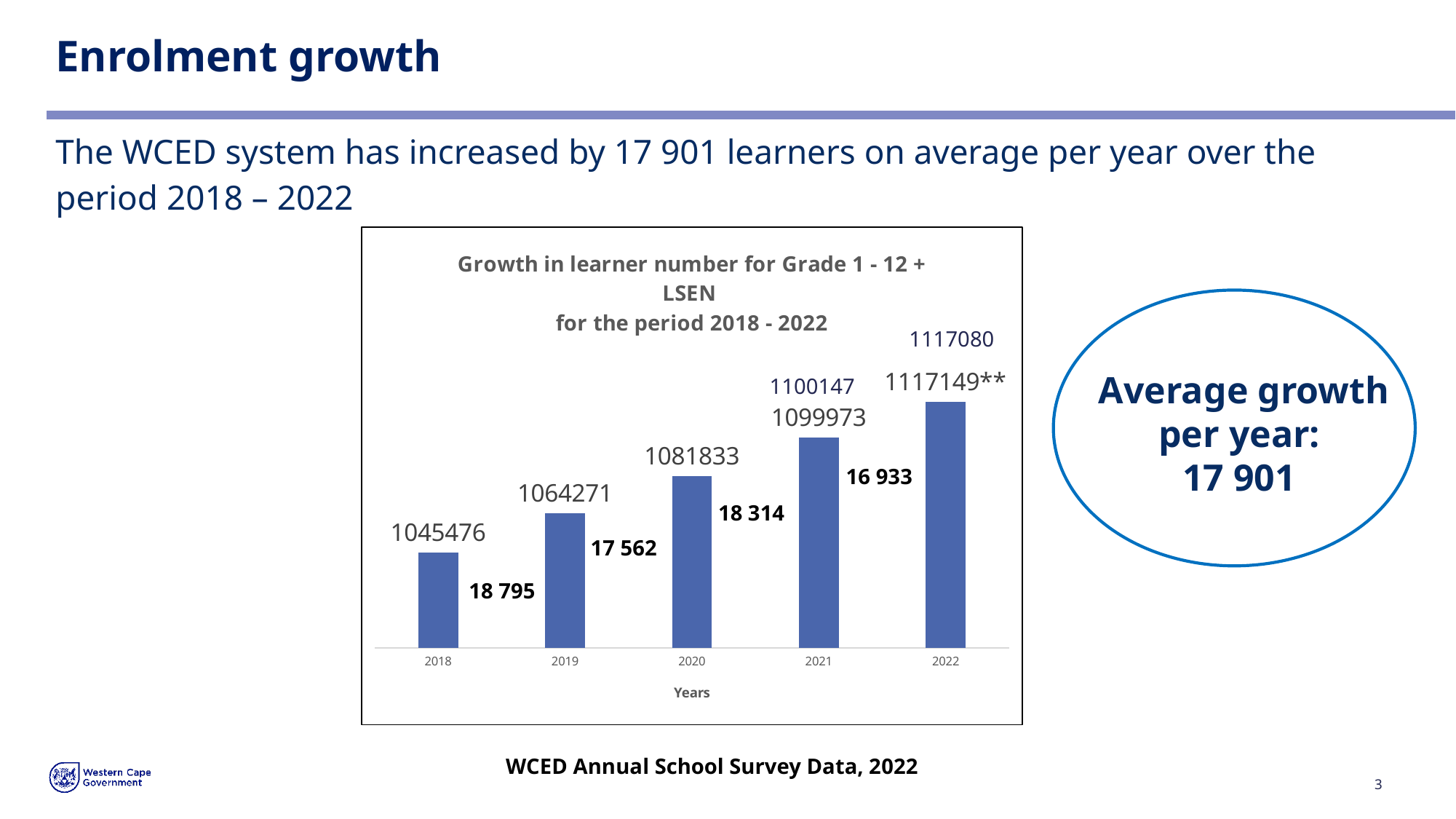
What is the learner number shown for 2020? 1081833 Which year has the larger learner number, 2019 or 2020? 2020 What is the title of the x axis of the chart? Years By how much did the learner number increase from 2018 to 2019? 18 795 What is the learner number shown for 2019? 1064271 Do the learner numbers rise or fall from 2018 to 2022? rise By how much did the learner number increase from 2019 to 2020? 17 562 How many years are plotted on the x axis of the chart? 5 Which year has the lowest learner number in the chart? 2018 What kind of chart is shown on the slide? bar chart What is the learner number shown for 2018? 1045476 Which year has the highest learner number in the chart? 2022